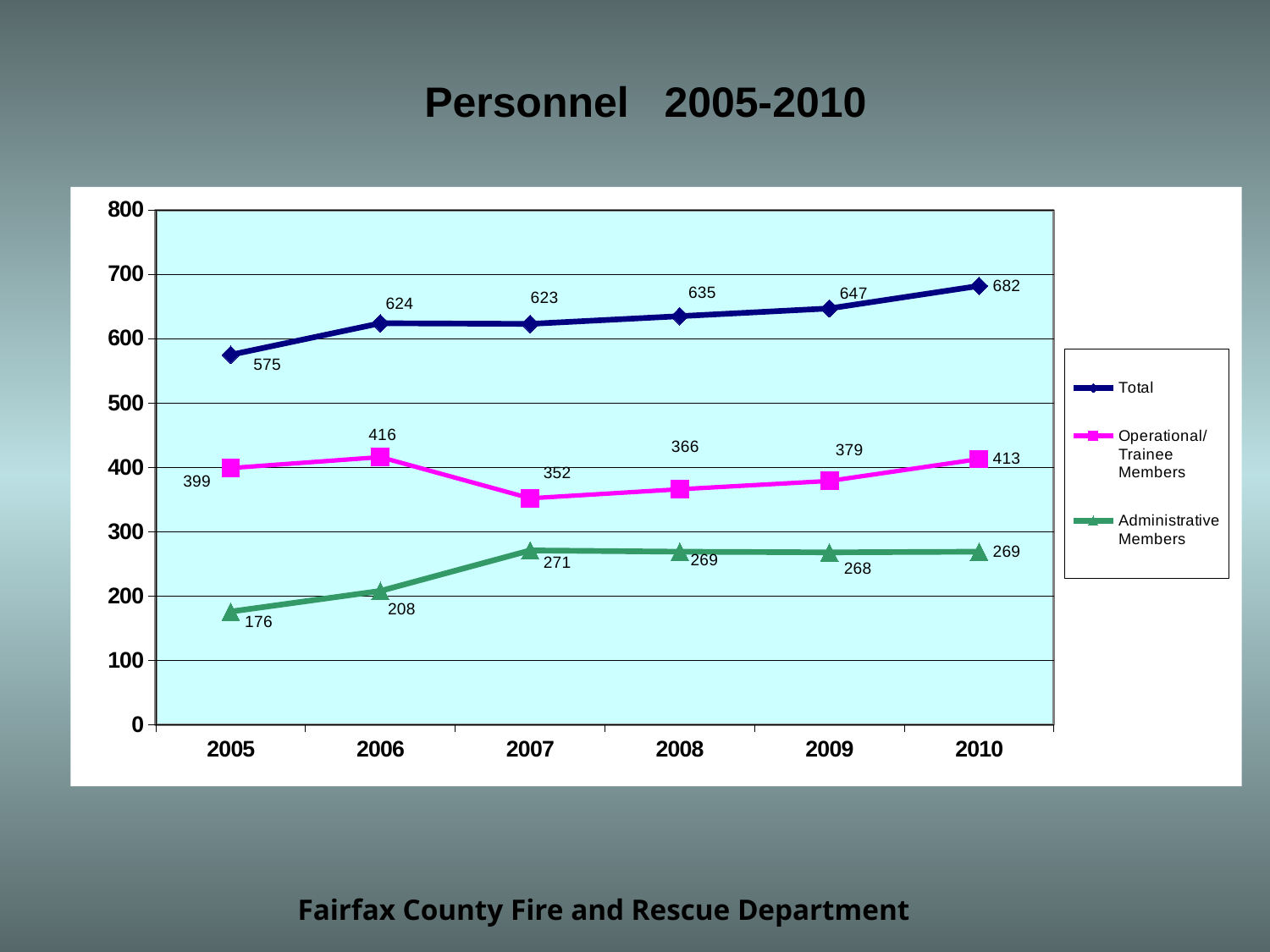
How many years are shown on the x axis? 6 What is the Total personnel value for 2010? 682 What is the value for Operational/Trainee Members in 2007? 352 Which is larger: Operational/Trainee Members in 2006 or in 2010? 2006 What kind of chart is shown on the slide? line chart What is the value for Administrative Members in 2005? 176 In which year is the Operational/Trainee Members series at its highest? 2006 In which year is the Total series at its lowest? 2005 What is the difference between the Total values for 2010 and 2005? 107 Does the Total series rise or fall from 2005 to 2010? rise How many series does the legend list? 3 Is the Administrative Members value for 2007 greater or less than 300? less